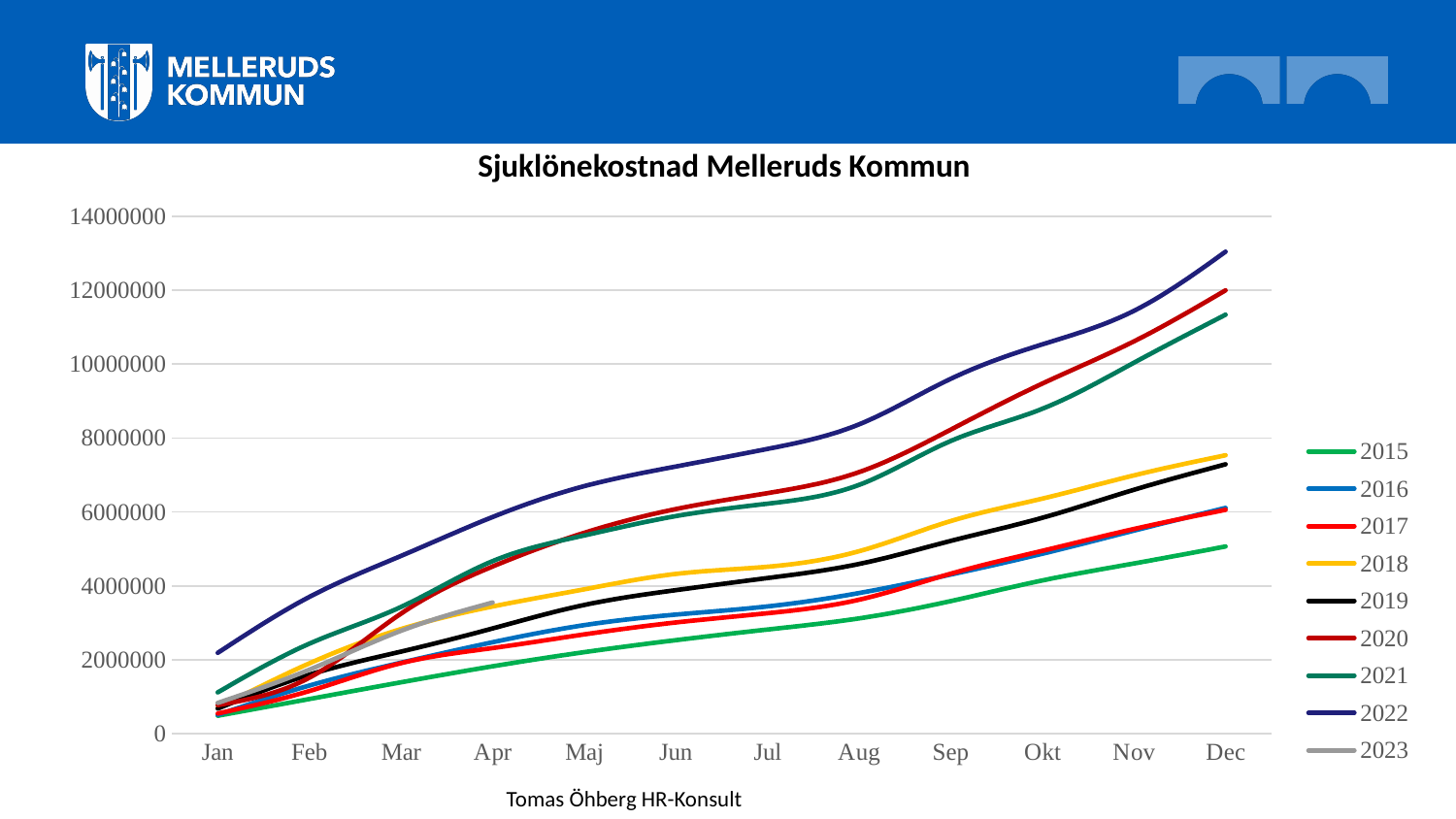
What is the title of the chart? Sjuklönekostnad Melleruds Kommun Is the value for 2022 in Dec greater or less than 12000000? greater In Dec, which is larger: the value for 2021 or the value for 2019? 2021 How many months are shown along the x axis? 12 Is the value for 2015 in Dec greater or less than 4000000? greater Which year's line is highest in Dec? 2022 How many series does the legend list? 9 Does the 2022 line rise or fall from Jan to Dec? rise What kind of chart is shown on the slide? line chart Is the value for 2023 in Apr greater or less than 4000000? less Which year's line is lowest in Dec? 2015